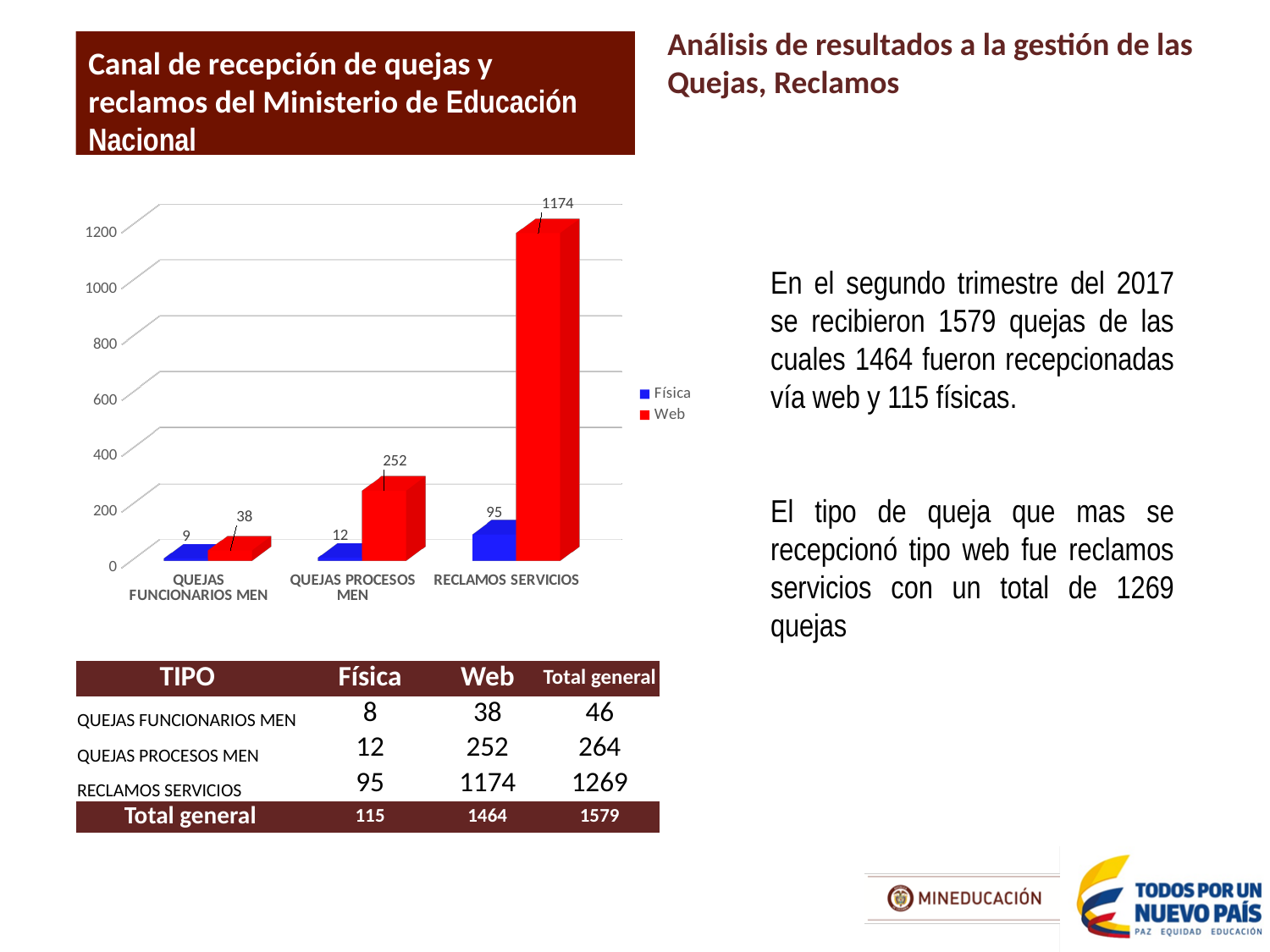
Which is larger in the chart: the Web value for QUEJAS PROCESOS MEN or the Física value for RECLAMOS SERVICIOS? Web value for QUEJAS PROCESOS MEN What is the Web value for RECLAMOS SERVICIOS in the chart? 1174 How many categories are shown on the x axis of the chart? 3 What is the Web value for QUEJAS FUNCIONARIOS MEN in the chart? 38 Which category has the lowest Física value in the chart? QUEJAS FUNCIONARIOS MEN What is the Física value for QUEJAS PROCESOS MEN in the chart? 12 What is the difference between the Web values for RECLAMOS SERVICIOS and QUEJAS PROCESOS MEN in the chart? 922 What kind of chart is shown on the slide? Bar chart Which category has the highest Web value in the chart? RECLAMOS SERVICIOS What is the Física value for RECLAMOS SERVICIOS in the chart? 95 How many series does the chart legend list? 2 Which colour represents the Web series in the chart? Red